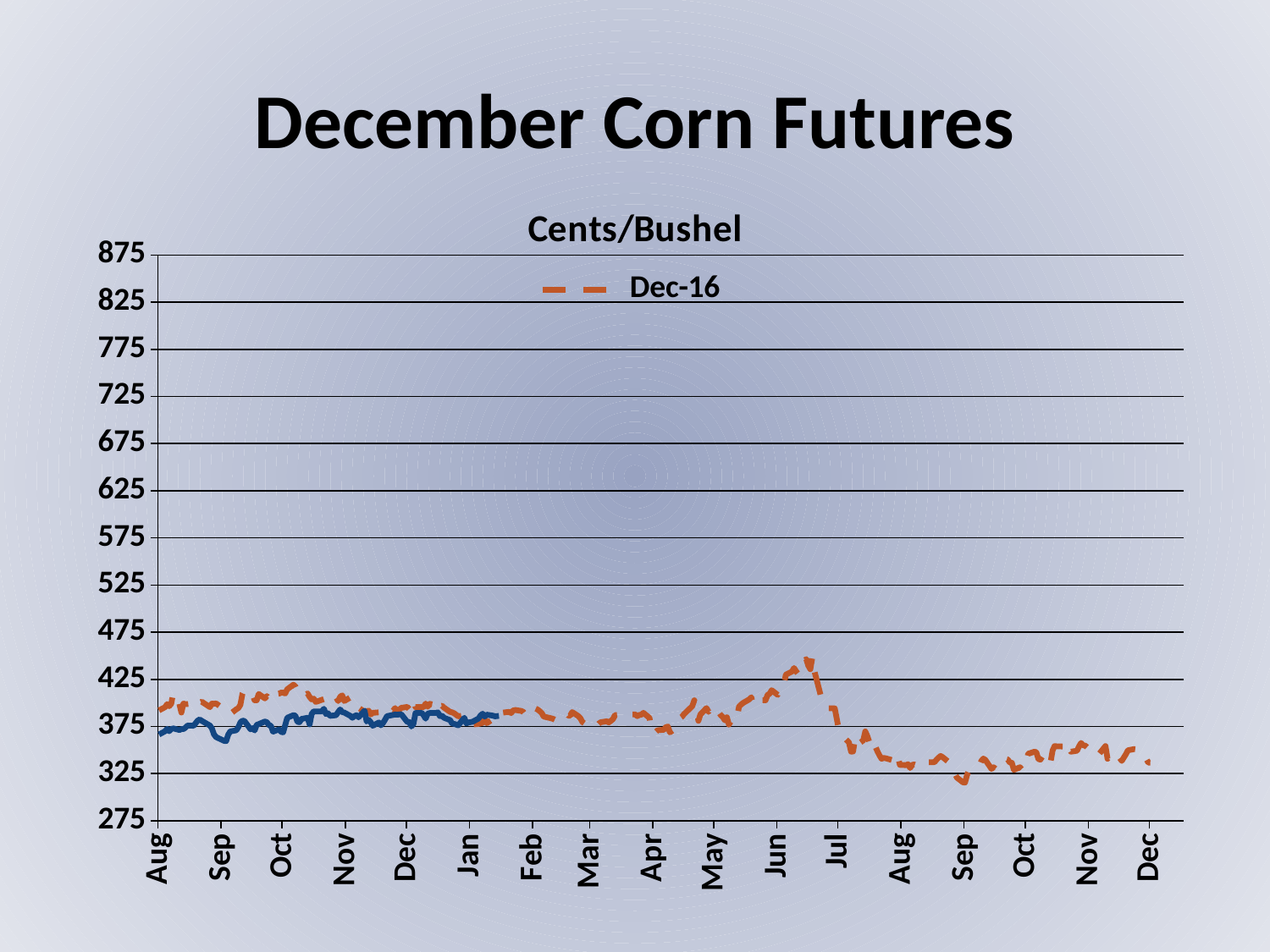
In which month does the Dec-16 series reach its highest value? Jun How many series does the legend list? 1 Is the lowest value of the Dec-16 series around the second Sep greater or less than 325? less What unit label appears above the chart? Cents/Bushel Is the Dec-16 value around Jun larger or smaller than its value around the second Aug? larger How many month labels are shown along the x axis? 17 Is the peak value of the Dec-16 series around Jun greater or less than 425? greater What kind of chart is shown on the slide? line chart Is the value of the Dec-16 series at the final Dec greater or less than 375? less What is the title of the chart on the slide? December Corn Futures Does the Dec-16 series rise or fall between Jun and Jul? fall